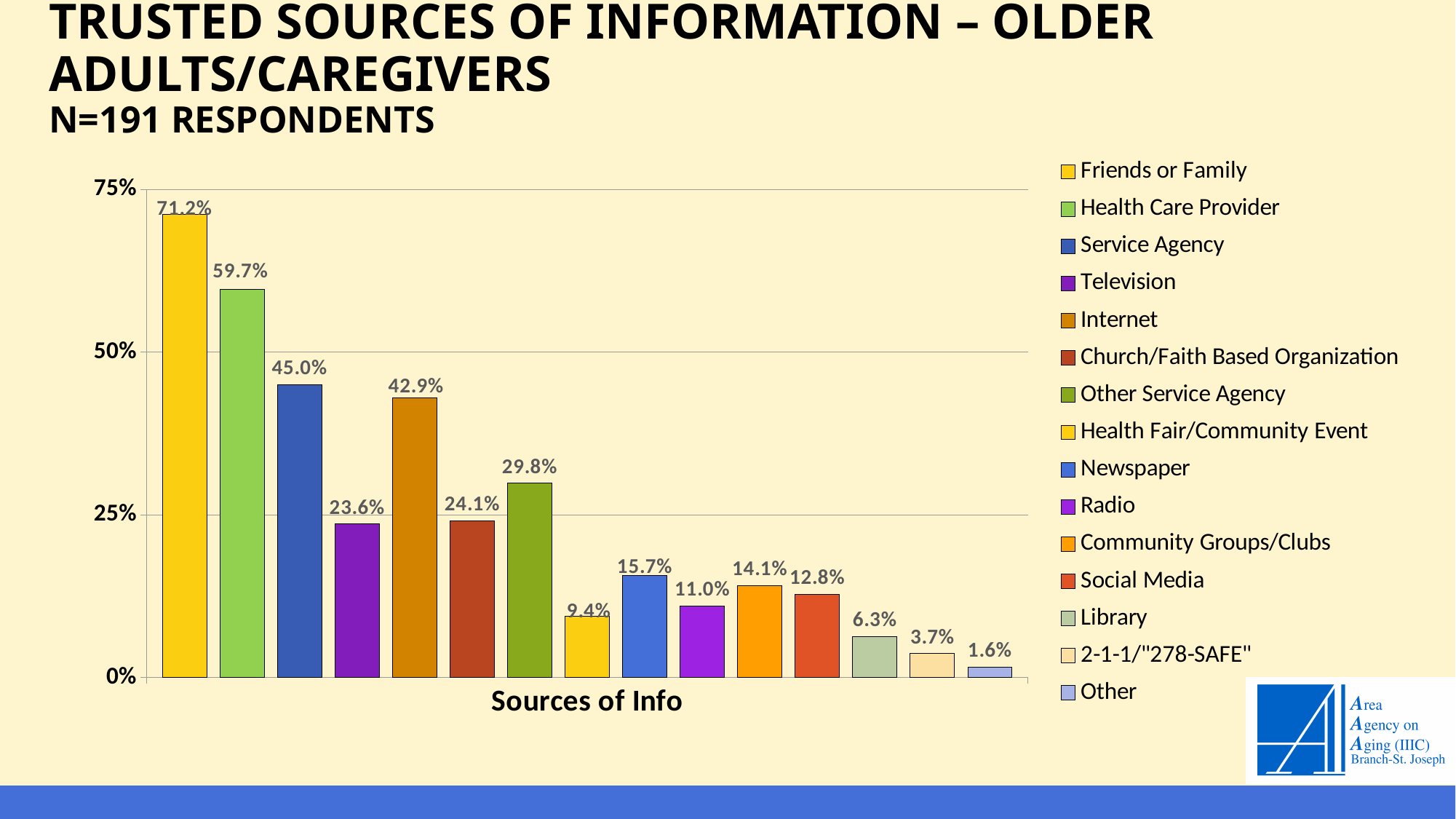
What is the label on the x axis of the chart? Sources of Info Which source of information has the highest percentage? Friends or Family What percentage of respondents named Friends or Family as a trusted source of information? 71.2% What is the value shown for Health Care Provider? 59.7% What is the value for Library? 6.3% What is the difference in percentage points between Friends or Family and Health Care Provider? 11.5 Which source of information has the lowest percentage? Other What percentage is shown for Internet? 42.9% Which is larger, the value for Television or the value for Church/Faith Based Organization? Church/Faith Based Organization Is the value for Other Service Agency greater or less than 25%? greater How many bars are plotted in the chart? 15 What kind of chart is shown on the slide? Bar chart